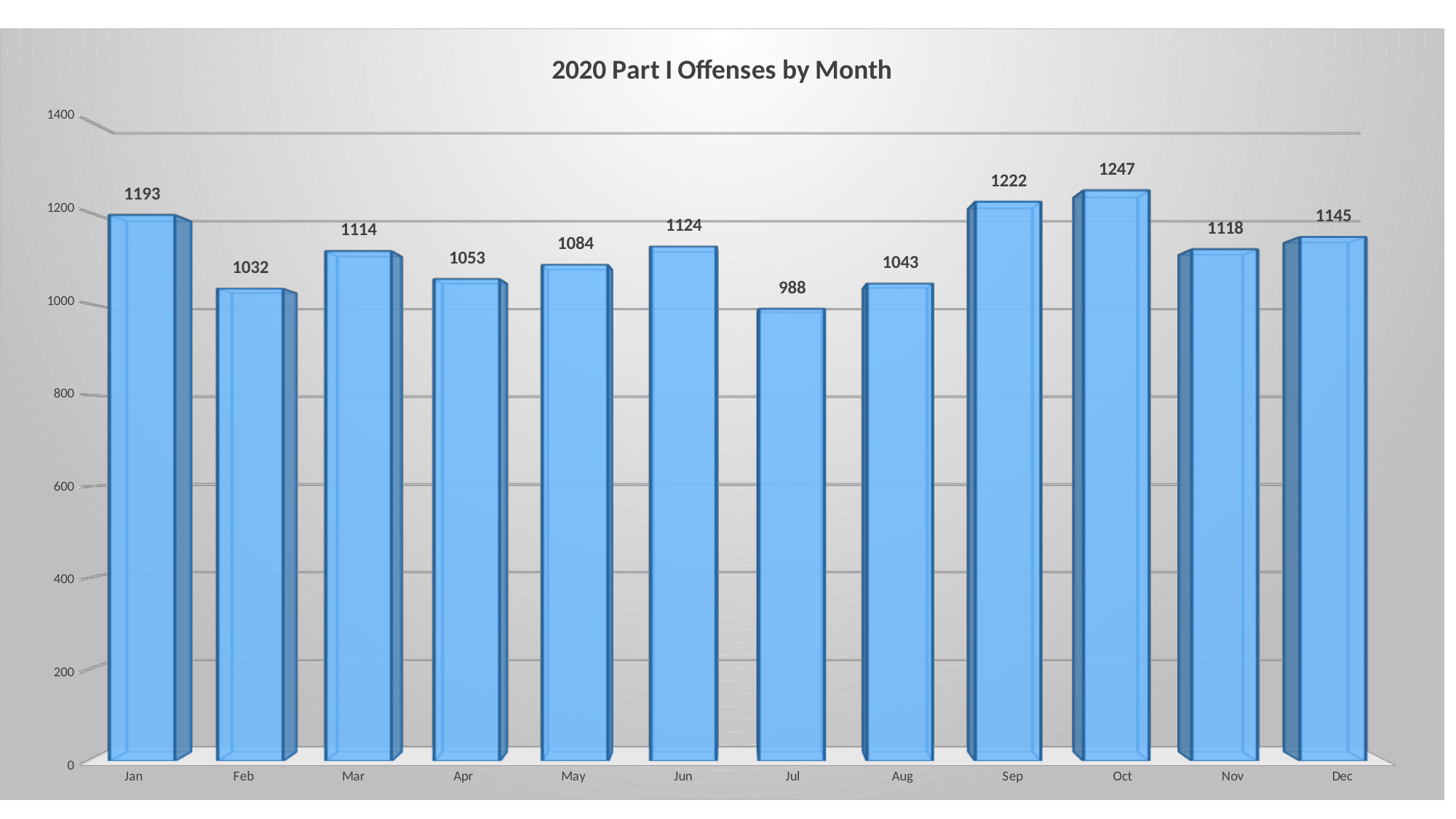
How many months are shown on the x axis? 12 What kind of chart is shown on the slide? bar chart What is the value for Jan? 1193 Which is larger, the value for Mar or the value for Nov? Nov What is the title of the chart? 2020 Part I Offenses by Month What is the difference between the values for Jan and Feb? 161 What is the value for Sep? 1222 Which month has the highest value? Oct Is the value for Feb greater or less than 1000? greater What is the value for Jul? 988 Which month has the lowest value? Jul What is the difference between the values for Oct and Jul? 259